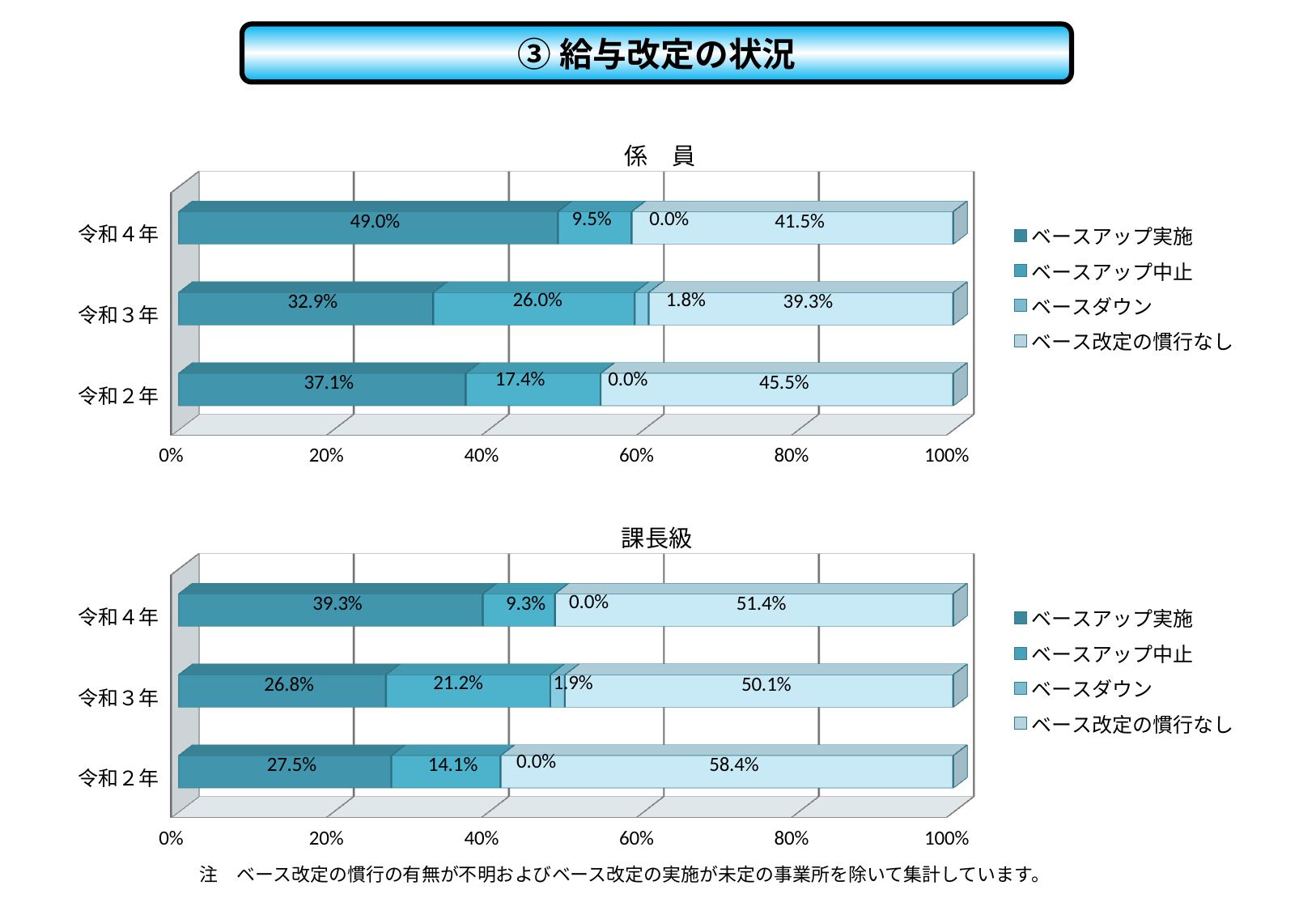
In the 課長級 chart, what is the value of ベース改定の慣行なし for 令和２年? 58.4% In the 係員 chart, what is the value of ベースアップ実施 for 令和４年? 49.0% In the 係員 chart, what is the difference between the ベースアップ実施 values for 令和４年 and 令和３年? 16.1% In the 係員 chart, what is the value of ベースダウン for 令和３年? 1.8% In the 係員 chart, which year has the highest value for ベースアップ実施? 令和４年 In the 課長級 chart, what is the value of ベースアップ中止 for 令和３年? 21.2% How many years are shown in the 課長級 chart? 3 In the 課長級 chart, which is larger: ベース改定の慣行なし for 令和４年 or for 令和３年? 令和４年 What kind of chart is the 係員 chart? Stacked bar chart In the 課長級 chart, which year has the lowest value for ベースアップ中止? 令和４年 How many series does the legend of the 係員 chart list? 4 What is the title of the bottom chart on the slide? 課長級